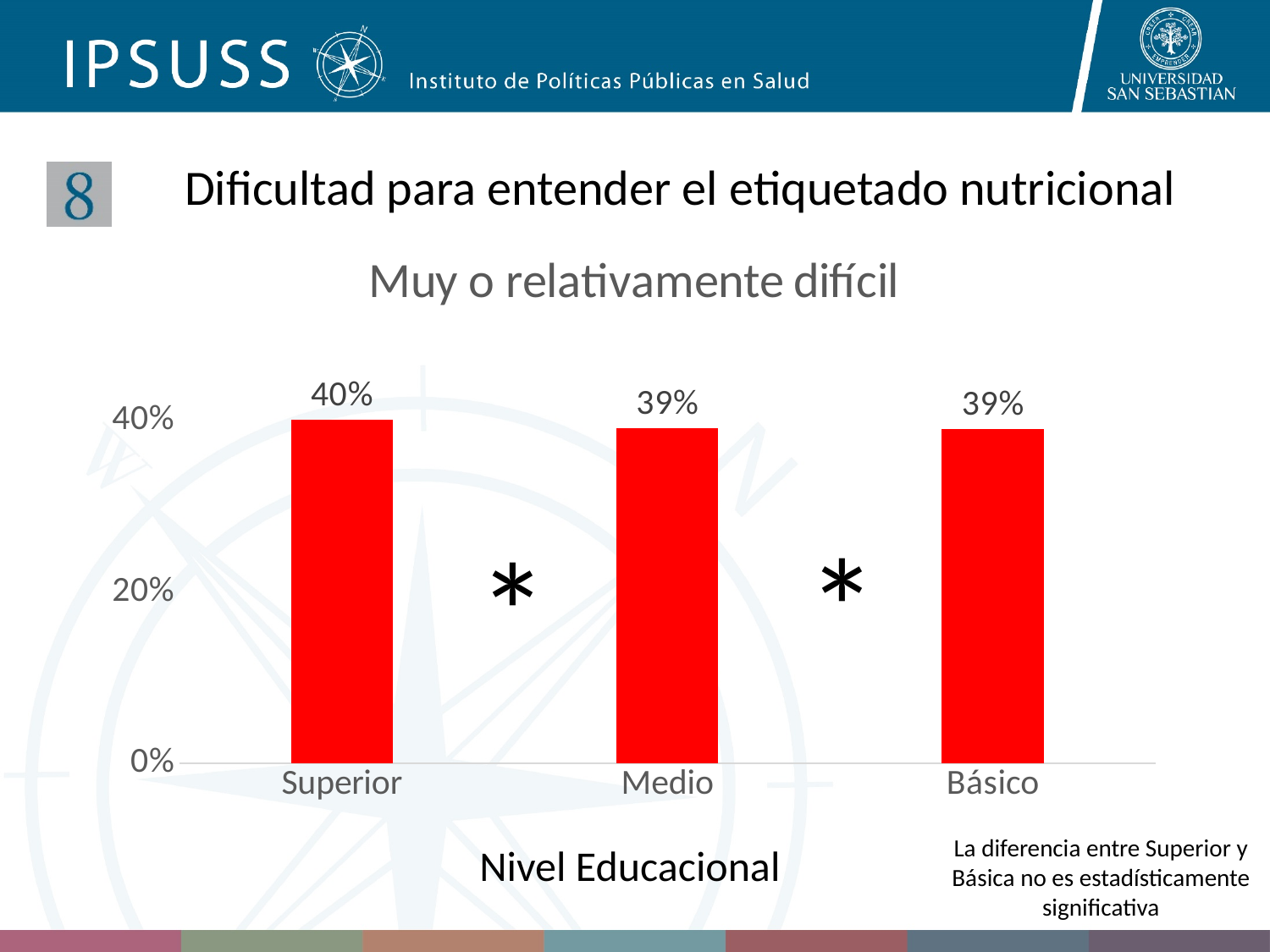
Which educational level has the highest value? Superior What is the label of the x axis? Nivel Educacional What is the value for Medio? 39% What kind of chart is shown on the slide? bar chart What is the difference between the values for Superior and Medio? 1% How many educational levels are shown on the x axis? 3 What is the value for Básico? 39% Do the values rise or fall from Superior to Básico? fall Which is larger, the value for Superior or the value for Básico? Superior What is the title of the chart? Muy o relativamente difícil Is the value for Medio greater or less than 20%? greater What is the value for Superior? 40%